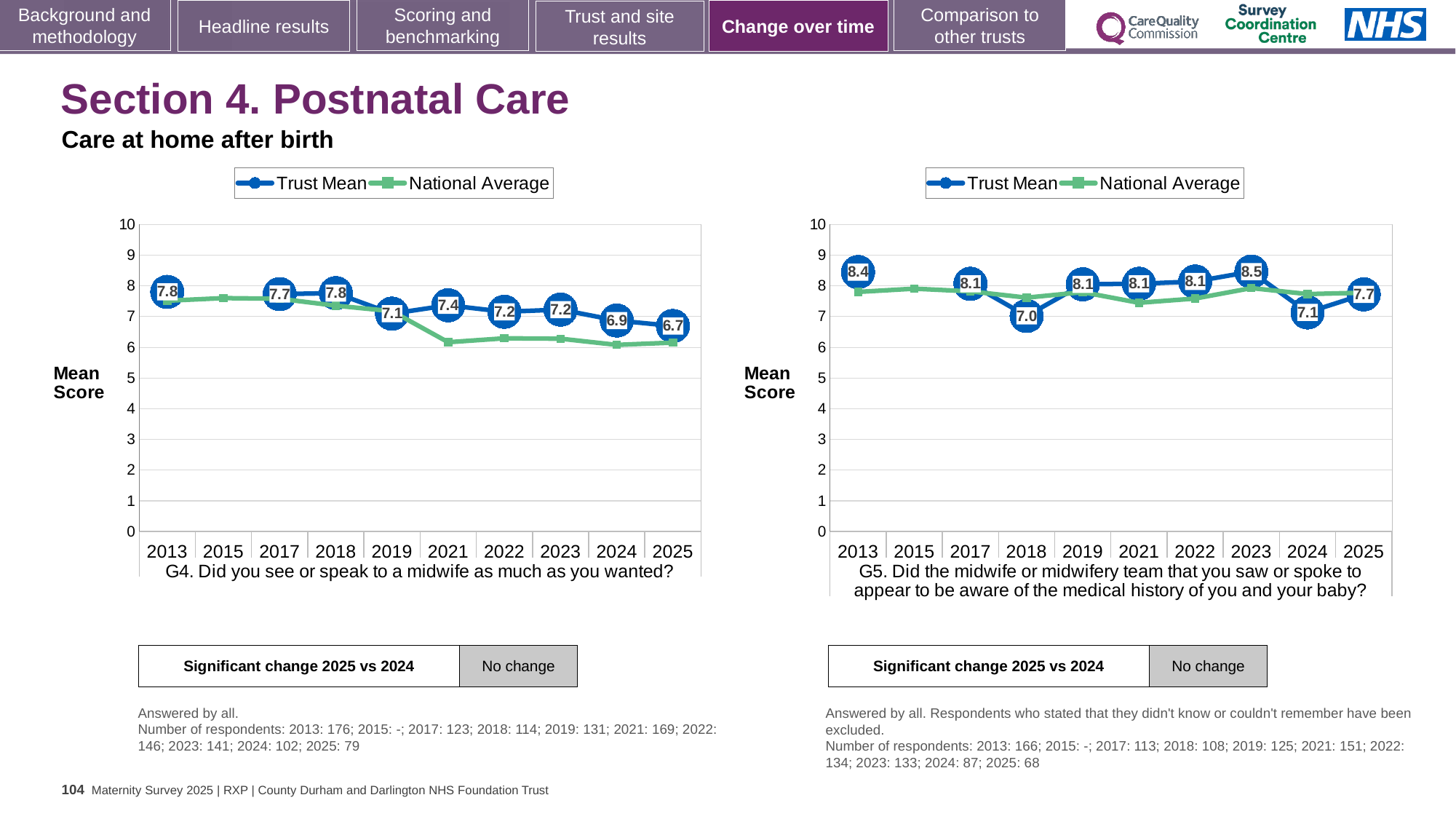
In the G4 chart (left), which year has the lowest Trust Mean score? 2025 In the G4 chart (left), which is larger: the Trust Mean score for 2021 or for 2024? 2021 How many years are shown on the x axis of the G5 chart (right)? 10 In the G5 chart (right), what is the difference between the Trust Mean scores for 2023 and 2024? 1.4 In the G5 chart (right), what is the Trust Mean score for 2018? 7.0 What type of chart is the G4 chart (left)? Line chart In the G4 chart (left), what is the Trust Mean score for 2013? 7.8 In the G4 chart (left), what is the Trust Mean score for 2025? 6.7 In the G4 chart (left), is the National Average value for 2025 greater or less than 7? less In the G5 chart (right), is the National Average value for 2018 greater or less than 7? greater How many series does the legend of the G4 chart (left) list? 2 In the G5 chart (right), which year has the highest Trust Mean score? 2023